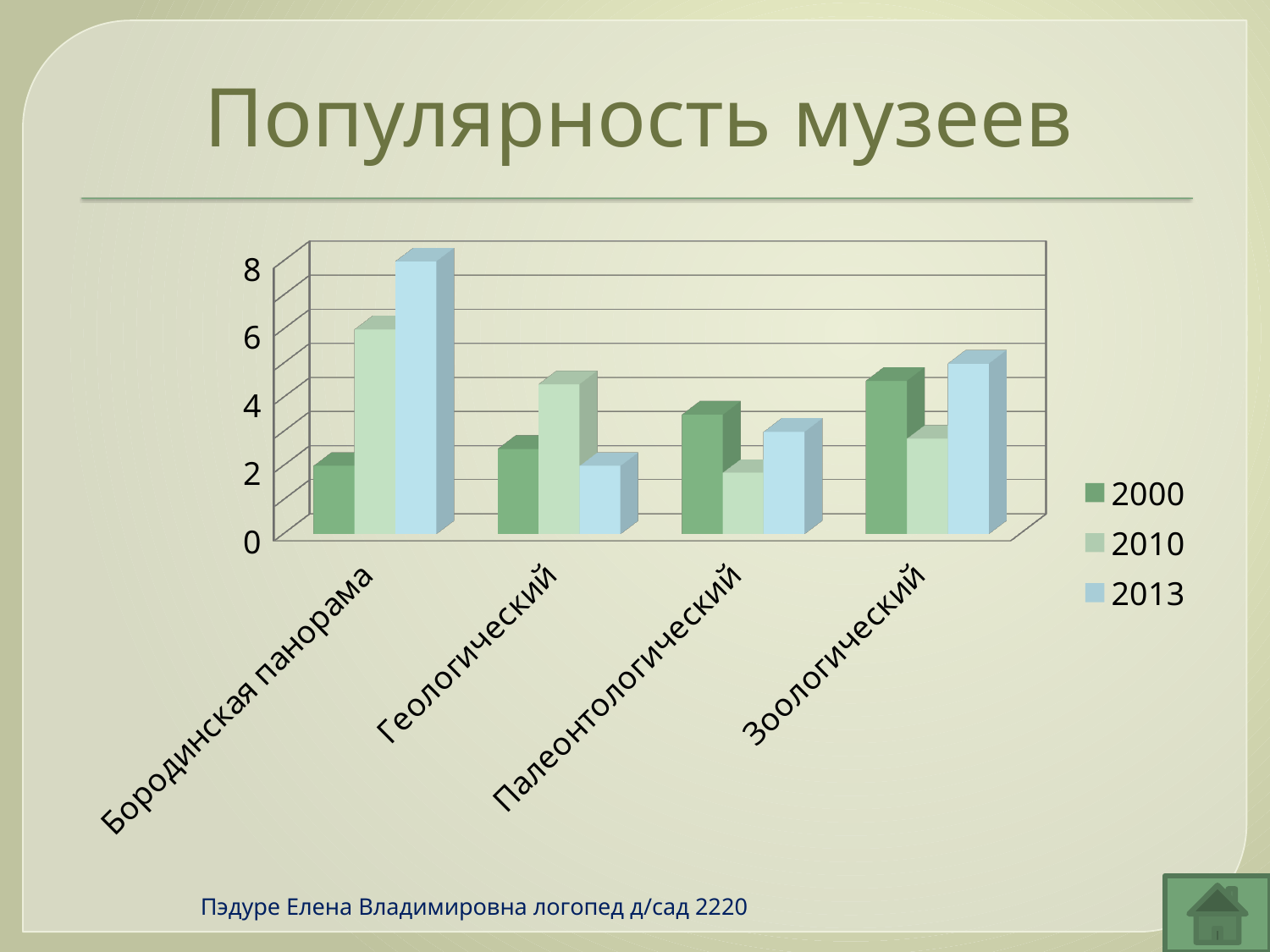
Which museum has the lowest value for 2010? Палеонтологический Which museum has the lowest value for 2013? Геологический For Геологический, which year has the larger value, 2010 or 2013? 2010 Is the 2013 value for Бородинская панорама greater or less than 6? greater Which museum has the highest value for 2010? Бородинская панорама What kind of chart is shown on the slide? bar chart How many series does the legend list? 3 Is the 2000 value for Бородинская панорама greater or less than 4? less How many museum categories are shown on the x axis? 4 Is the 2010 value for Палеонтологический greater or less than 4? less What is the title of the chart? Популярность музеев Which museum has the highest value for 2013? Бородинская панорама